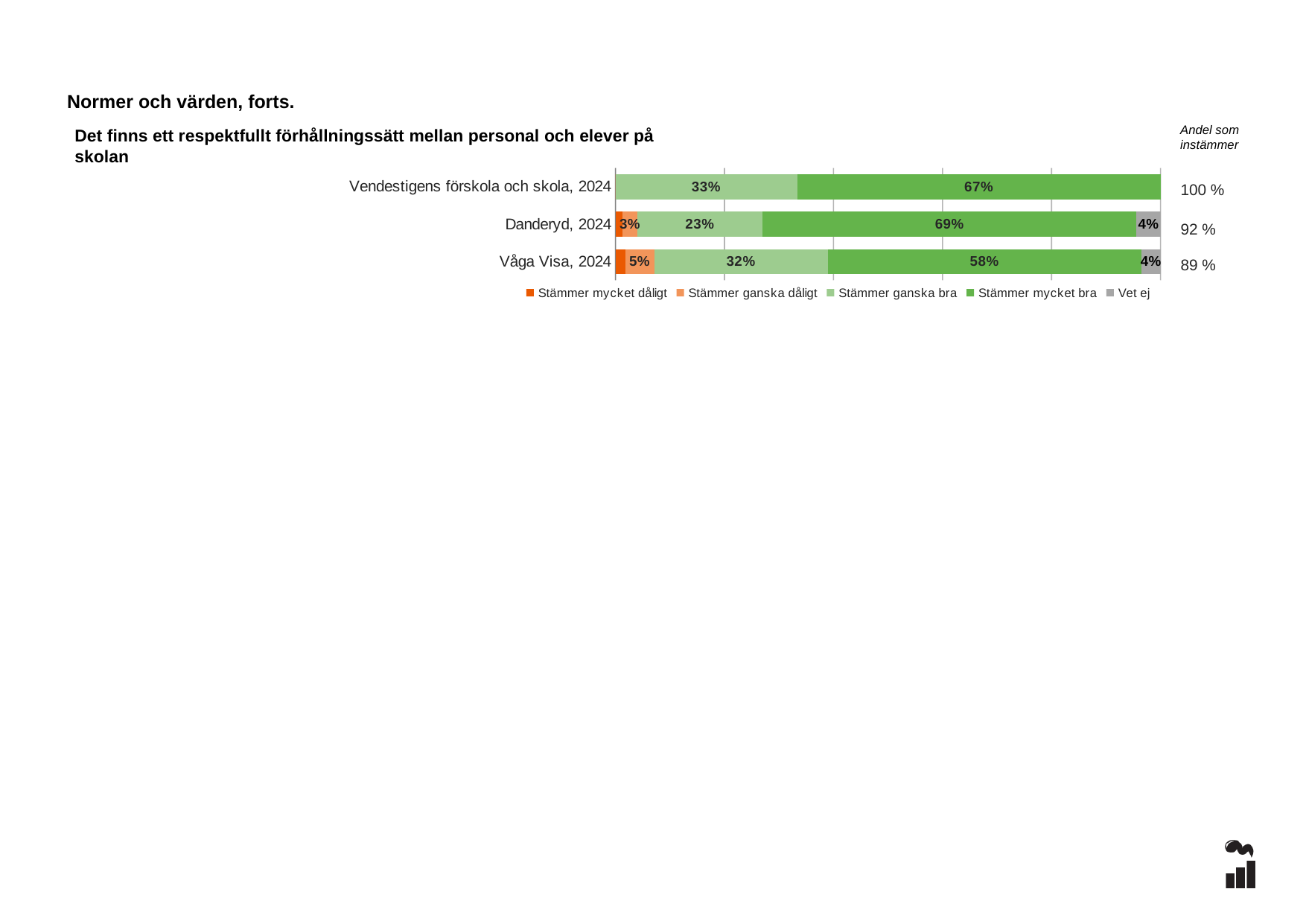
What is the 'Stämmer ganska bra' value for Danderyd, 2024? 23% What is the 'Andel som instämmer' value shown for Våga Visa, 2024? 89 % What is the 'Vet ej' value for Danderyd, 2024? 4% What is the 'Stämmer ganska dåligt' value for Våga Visa, 2024? 5% What is the 'Stämmer mycket bra' value for Vendestigens förskola och skola, 2024? 67% Which is larger: the 'Stämmer ganska bra' value for Vendestigens förskola och skola, 2024 or for Danderyd, 2024? Vendestigens förskola och skola, 2024 How many series does the legend list? 5 What is the difference between the 'Stämmer mycket bra' values for Danderyd, 2024 and Våga Visa, 2024? 11 percentage points How many categories (rows) does the chart show? 3 Which category has the lowest 'Stämmer mycket bra' value? Våga Visa, 2024 What kind of chart is shown on the slide? Stacked bar chart Which category has the highest 'Stämmer mycket bra' value? Danderyd, 2024